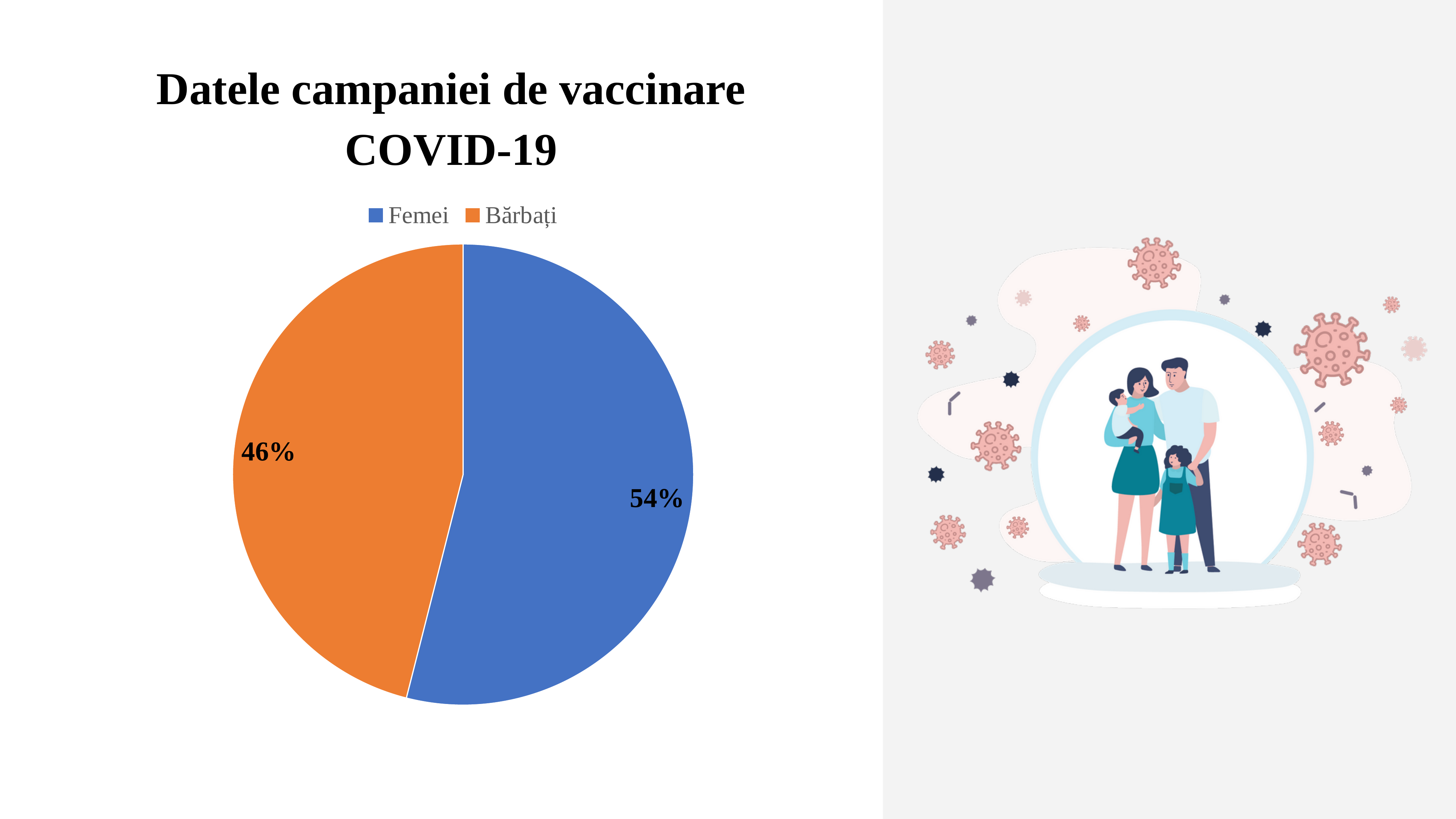
How many entries does the legend list? 2 What is the difference in percentage points between the Femei and Bărbați slices? 8% What share of the pie is Bărbați? 46% Which category has the smallest slice of the pie? Bărbați How many slices does the pie chart have? 2 What is the title shown above the chart? Datele campaniei de vaccinare COVID-19 Which category has the largest slice of the pie? Femei What colour is the Femei slice? blue Which slice is larger, Femei or Bărbați? Femei What kind of chart is shown on the slide? pie chart What share of the pie is Femei? 54%